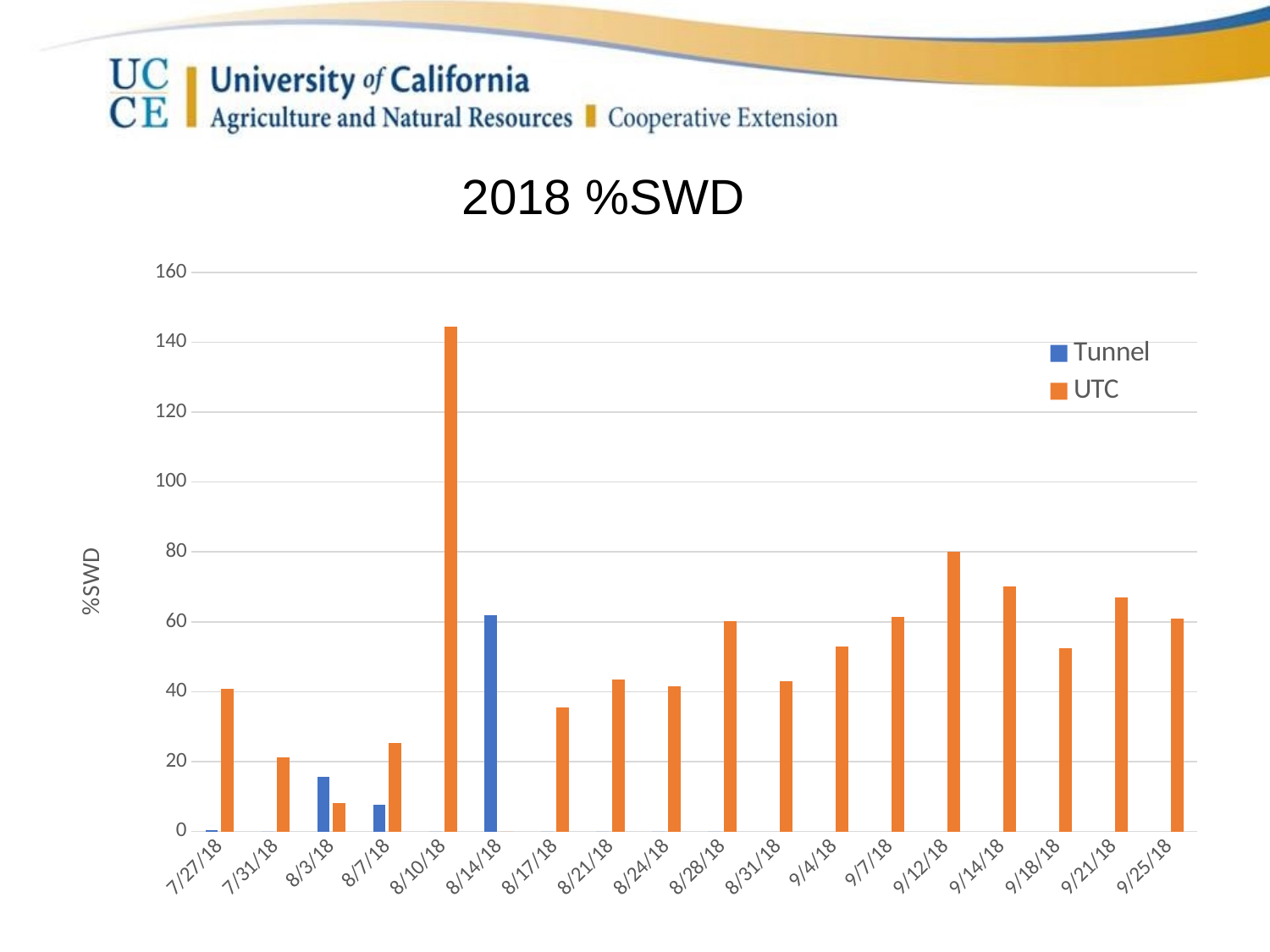
Which colour represents the UTC series? orange Is the UTC value for 9/12/18 greater or less than 60? greater Which is larger, the UTC value for 9/14/18 or the UTC value for 9/18/18? 9/14/18 Is the UTC value for 7/31/18 greater or less than 40? less On which date is the UTC value highest? 8/10/18 How many dates are shown along the x axis? 18 On which date is the Tunnel value highest? 8/14/18 What is the title of the chart? 2018 %SWD Which is larger on 8/3/18, the Tunnel value or the UTC value? Tunnel What kind of chart is shown on the slide? bar chart How many series does the legend list? 2 Is the UTC value for 8/10/18 greater or less than 140? greater